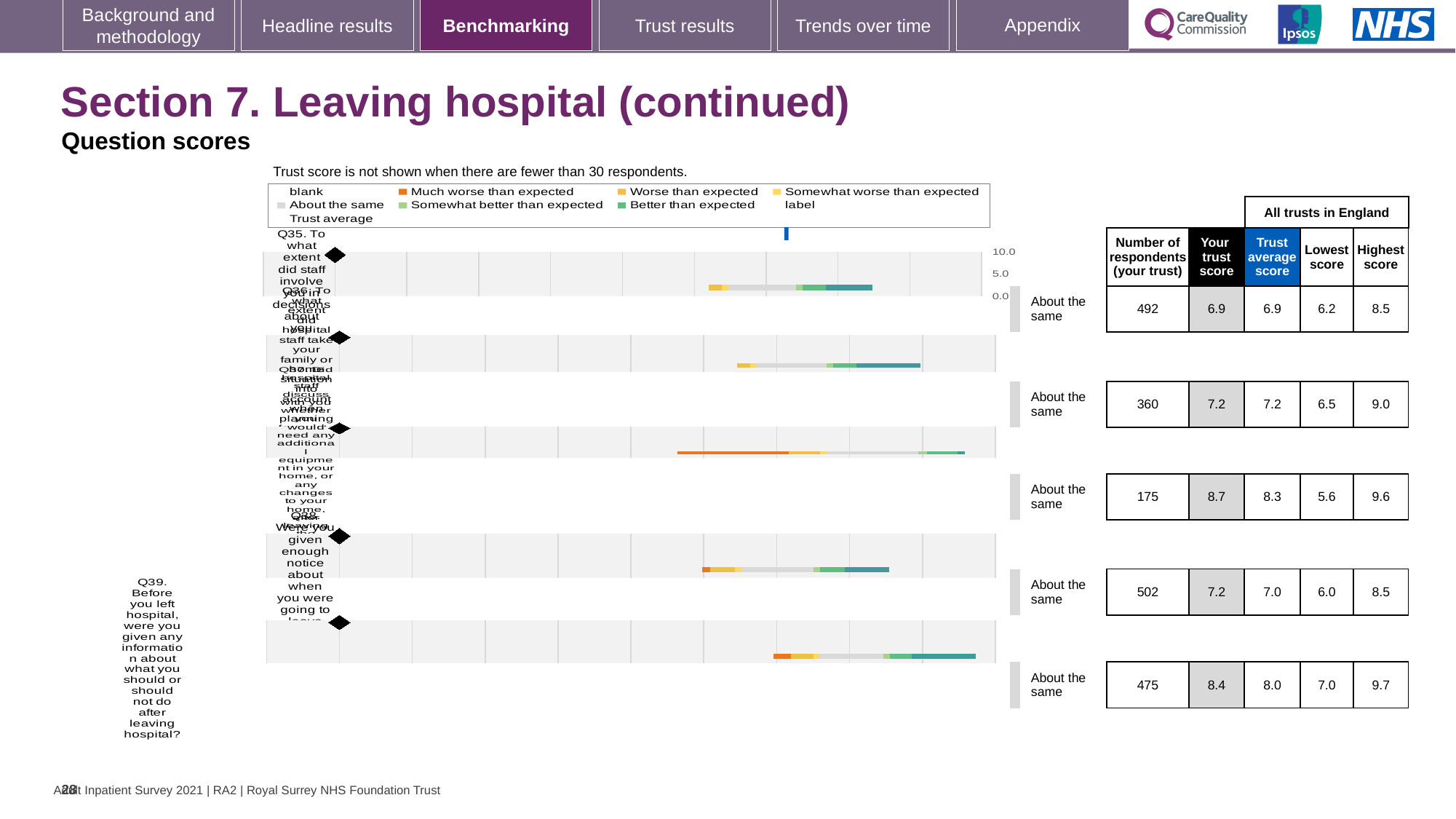
What is your trust score for Q39 (the last question row)? 8.4 What is the largest 'Your trust score' shown in the table? 8.7 What is the smallest 'Lowest score' value shown in the table? 5.6 How many question rows are plotted on the chart? 5 What is the highest score across all trusts in England for the question row with 175 respondents? 9.6 How many respondents from your trust answered Q35 (the first question row)? 492 What is the largest number of respondents shown for any question row? 502 What benchmark category is shown next to every question row? About the same For Q39 (the last question row), how much higher is your trust score than the trust average score? 0.4 For Q39 (the last question row), which is larger: your trust score or the trust average score? Your trust score What kind of chart is used to show the question scores? Bar chart What is the lowest score across all trusts in England for Q35 (the first question row)? 6.2